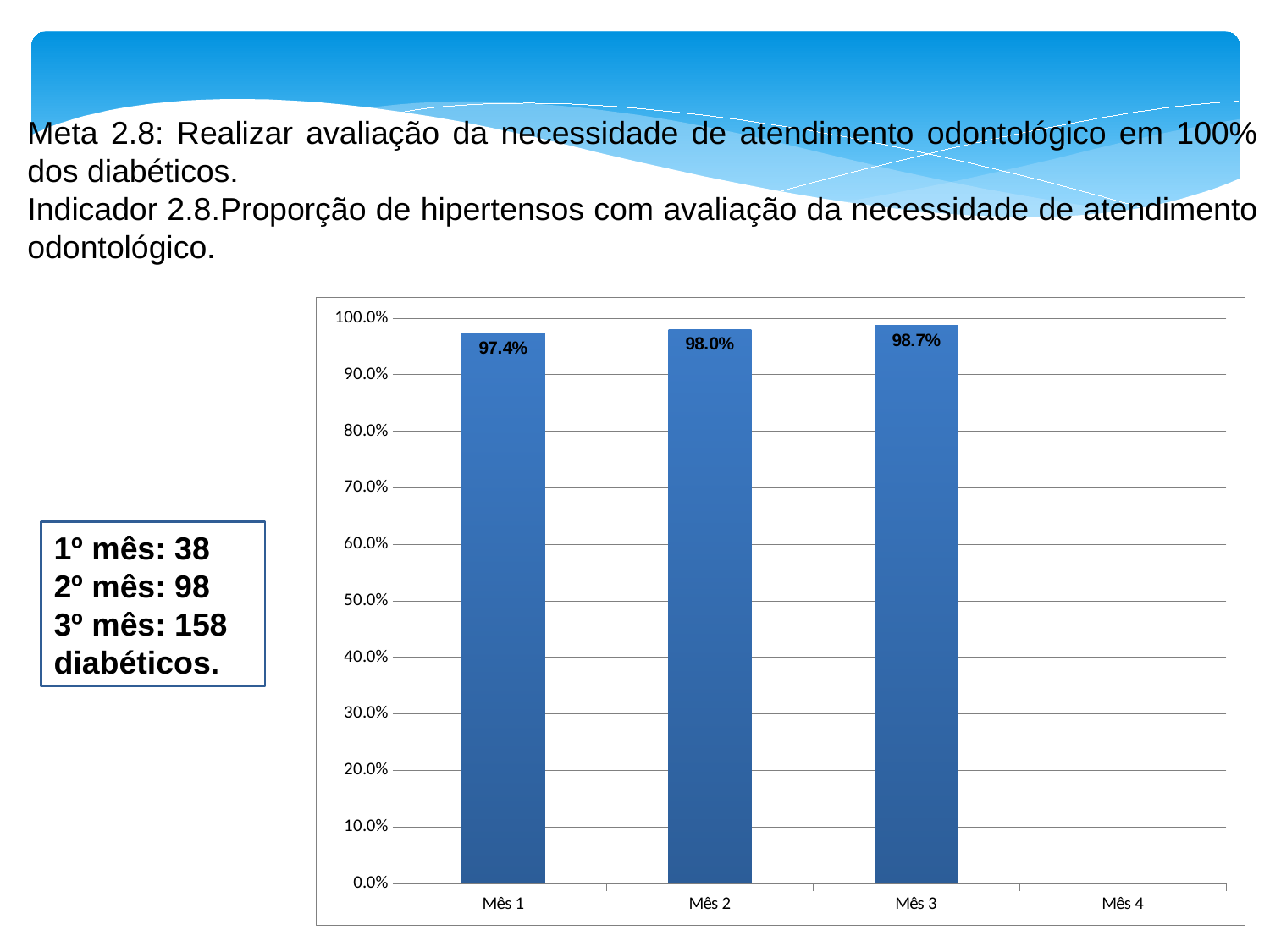
What is the value for Mês 3? 98.7% Do the values rise or fall from Mês 1 to Mês 3? Rise What kind of chart is shown on the slide? Bar chart Is the value for Mês 1 greater or less than 90.0%? greater Which month has the highest value? Mês 3 Among Mês 1, Mês 2 and Mês 3, which has the lowest value? Mês 1 What is the difference between the values for Mês 2 and Mês 1? 0.6 percentage points What is the difference between the values for Mês 3 and Mês 1? 1.3 percentage points What is the value for Mês 2? 98.0% How many categories are shown on the x axis? 4 What is the value for Mês 1? 97.4% Which is larger, the value for Mês 2 or the value for Mês 1? Mês 2